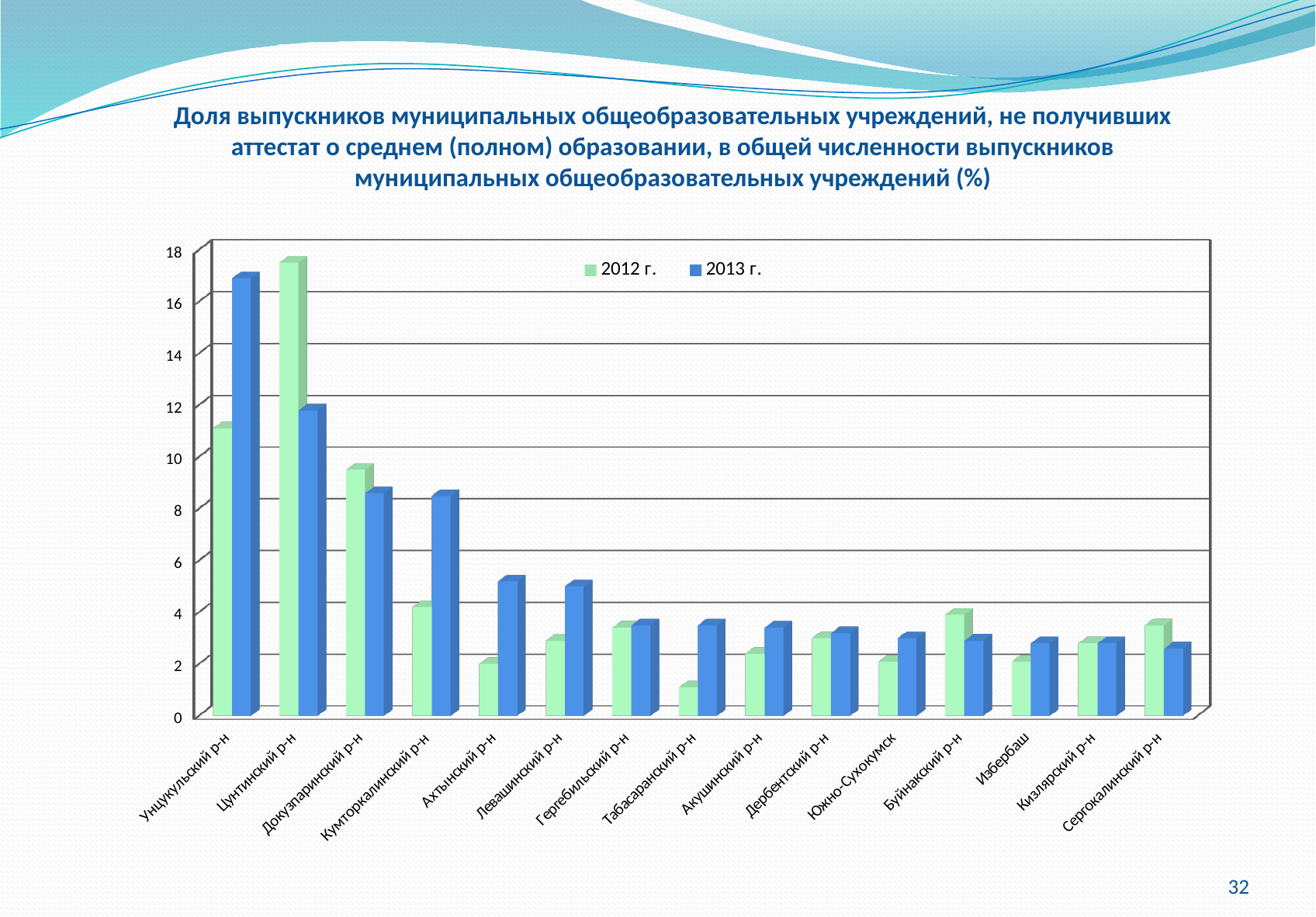
Which district has the lowest value for 2012 г.? Табасаранский р-н Which district has the highest value for 2012 г.? Цунтинский р-н Is the 2012 г. value for Цунтинский р-н greater or less than 16? greater For Цунтинский р-н, which year has the larger value, 2012 г. or 2013 г.? 2012 г. Which district has the highest value for 2013 г.? Унцукульский р-н How many districts (categories) are shown on the x axis? 15 How many series does the legend list? 2 What kind of chart is shown on the slide? bar chart What are the two entries in the chart legend? 2012 г. and 2013 г. Is the 2012 г. value for Табасаранский р-н greater or less than 2? less For Кумторкалинский р-н, which year has the larger value, 2012 г. or 2013 г.? 2013 г. Is the 2013 г. value for Унцукульский р-н greater or less than 16? greater